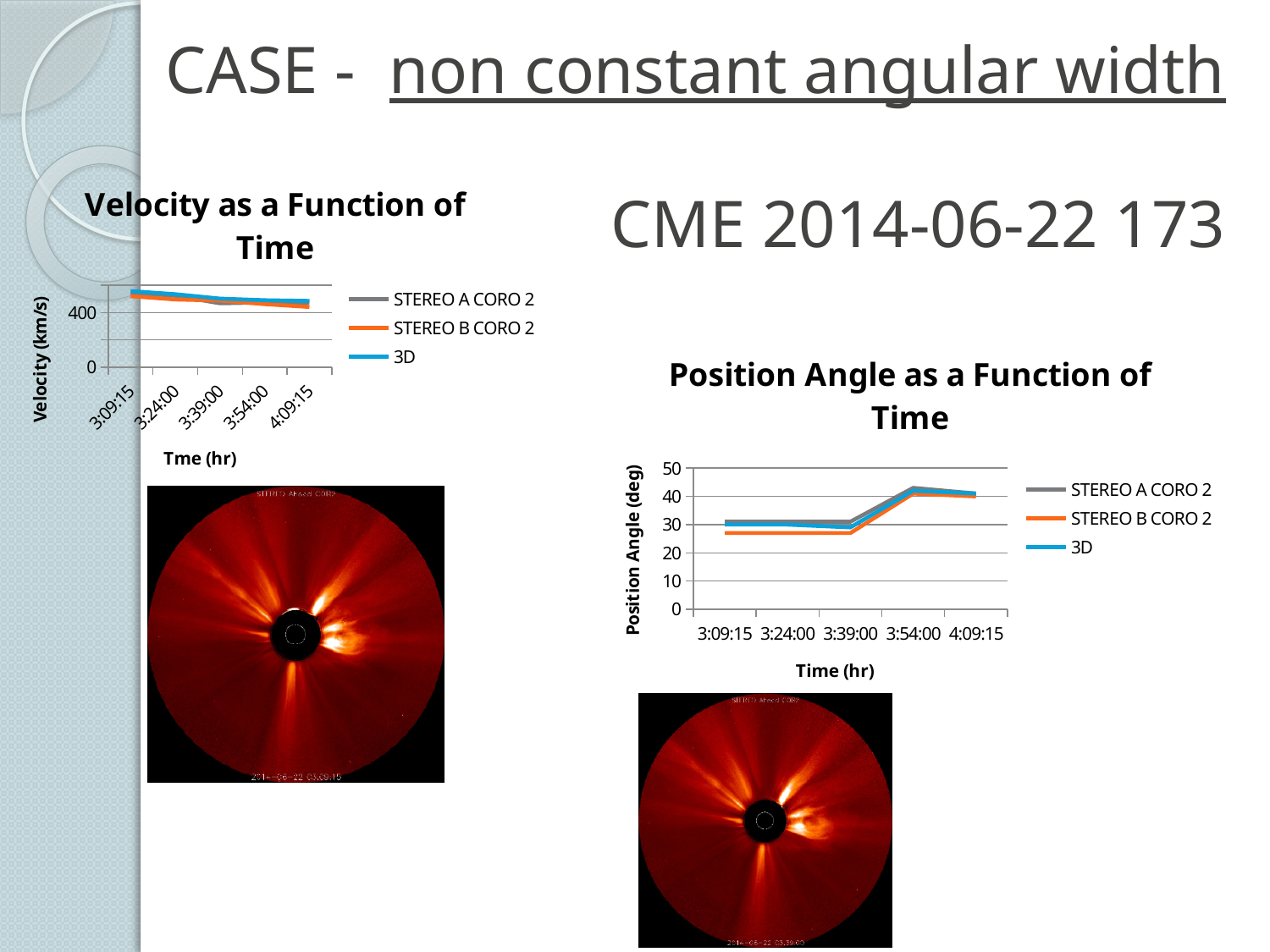
In the 'Position Angle as a Function of Time' chart, do the position angle values rise or fall from 3:09:15 to 3:54:00? rise How many series does the legend of the 'Velocity as a Function of Time' chart list? 3 In the 'Position Angle as a Function of Time' chart, is the STEREO B CORO 2 value at 3:09:15 greater or less than 30? less What kind of chart is the 'Position Angle as a Function of Time' chart? line chart What kind of chart is the 'Velocity as a Function of Time' chart? line chart What is the y-axis label of the 'Position Angle as a Function of Time' chart? Position Angle (deg) In the 'Velocity as a Function of Time' chart, is the STEREO A CORO 2 value at 3:09:15 greater or less than 400? greater In the 'Velocity as a Function of Time' chart, do the velocity values rise or fall from 3:09:15 to 4:09:15? fall How many series does the legend of the 'Position Angle as a Function of Time' chart list? 3 In the 'Position Angle as a Function of Time' chart, is the 3D value at 3:54:00 greater or less than 30? greater Which series in the 'Position Angle as a Function of Time' chart is drawn in orange? STEREO B CORO 2